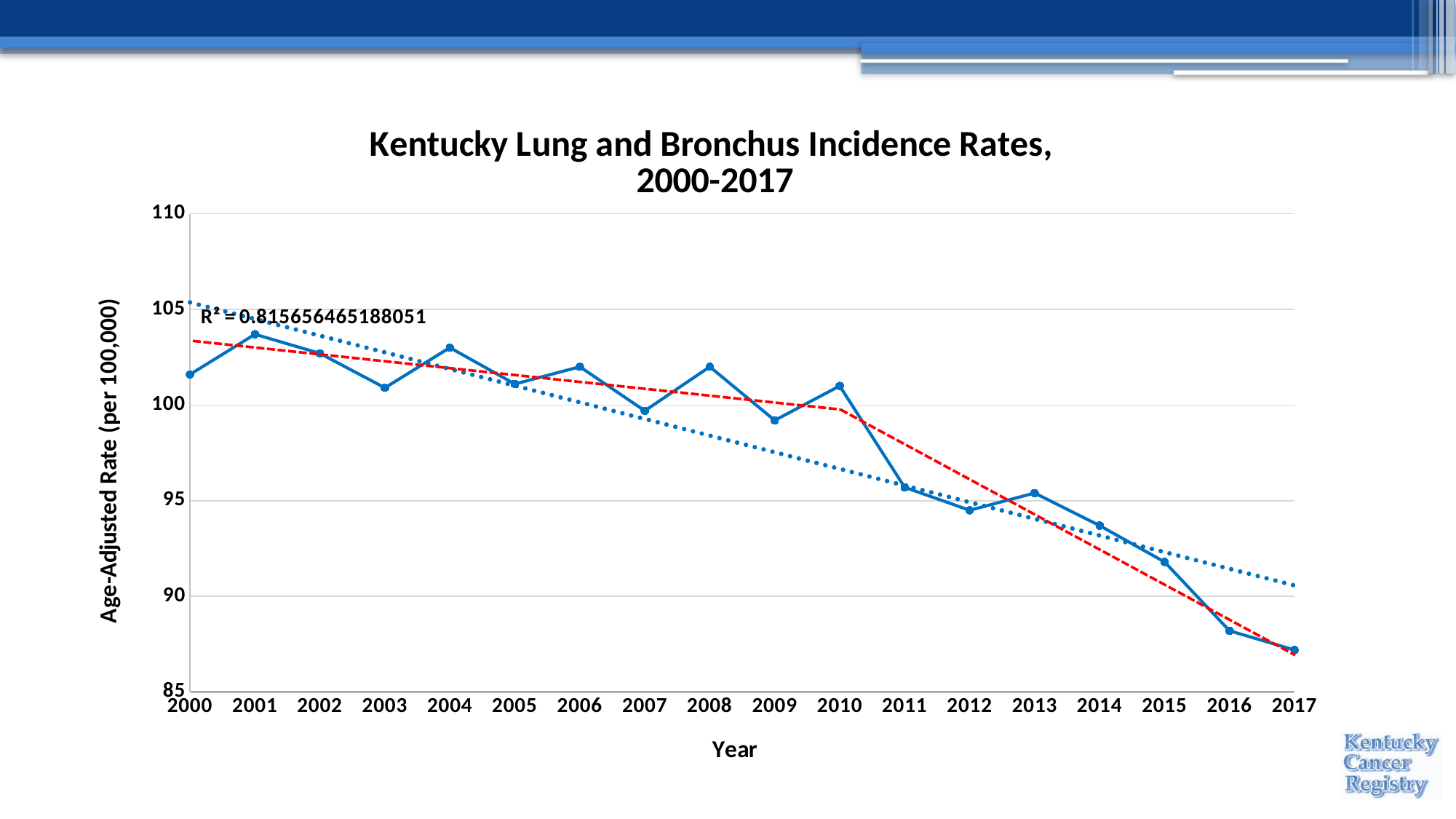
What R² value is printed on the chart? 0.815656465188051 Is the value for 2001 greater or less than 100? greater Is the value for 2011 greater or less than 100? less What kind of chart is shown on the slide? line chart Which year has the lowest age-adjusted incidence rate? 2017 Which is larger, the rate for 2010 or the rate for 2011? 2010 Is the value for 2015 greater or less than 90? greater Overall, do the incidence rates rise or fall from 2000 to 2017? fall How many years (data points) are plotted on the chart? 18 What is the title of the y axis? Age-Adjusted Rate (per 100,000) Which is larger, the rate for 2000 or the rate for 2017? 2000